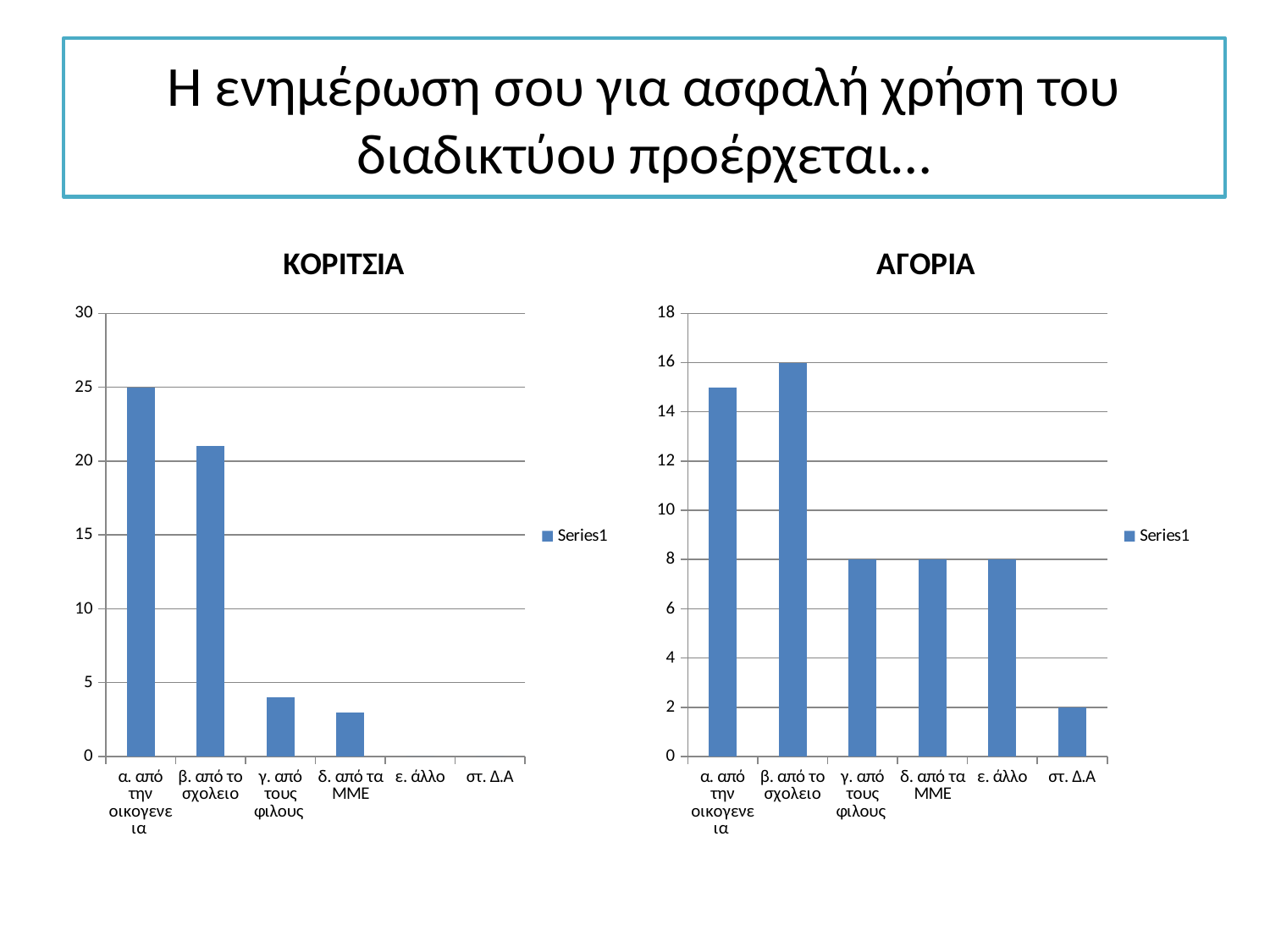
In the ΚΟΡΙΤΣΙΑ chart, which category has the highest value? α. από την οικογενεια In the ΚΟΡΙΤΣΙΑ chart, what is the value for α. από την οικογενεια? 25 What kind of chart is the ΚΟΡΙΤΣΙΑ chart? bar chart In the ΑΓΟΡΙΑ chart, what is the difference between the values for β. από το σχολειο and στ. Δ.Α? 14 How many series does the legend of the ΚΟΡΙΤΣΙΑ chart list? 1 In the ΑΓΟΡΙΑ chart, which category has the highest value? β. από το σχολειο In the ΚΟΡΙΤΣΙΑ chart, is the value for β. από το σχολειο greater or less than 20? greater In the ΑΓΟΡΙΑ chart, what is the value for ε. άλλο? 8 In the ΑΓΟΡΙΑ chart, what is the value for β. από το σχολειο? 16 In the ΑΓΟΡΙΑ chart, which category has the lowest value? στ. Δ.Α How many categories are shown on the x axis of the ΑΓΟΡΙΑ chart? 6 In the ΑΓΟΡΙΑ chart, what is the value for στ. Δ.Α? 2